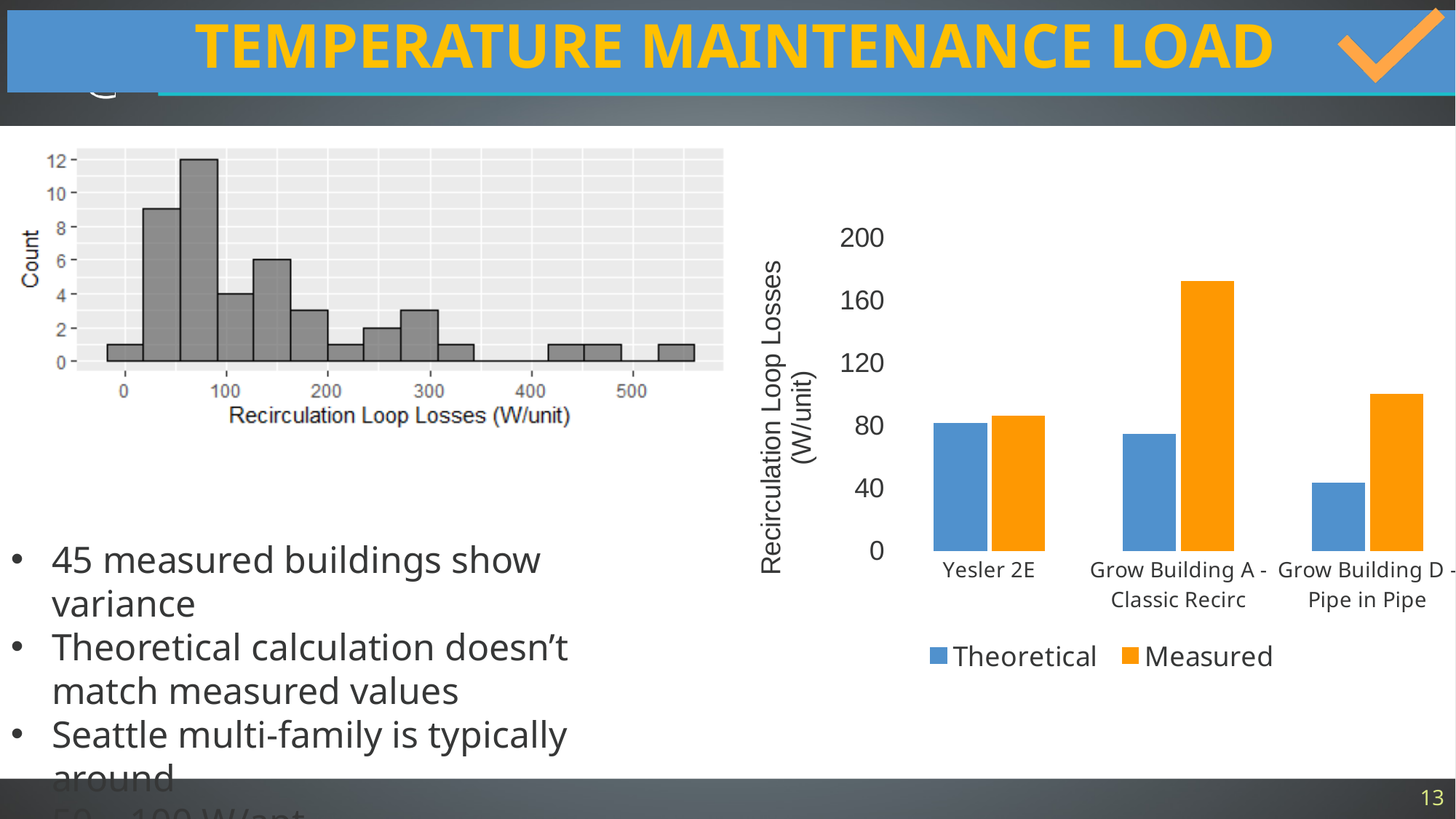
In the chart on the right, is the Measured value for Grow Building A - Classic Recirc greater or less than 160? greater What kind of chart is the chart on the right of the slide? bar chart In the histogram on the left, what is the highest count reached by any bar? 12 In the chart on the right, what are the two entries in the legend? Theoretical and Measured In the chart on the right, which building has the highest Measured value? Grow Building A - Classic Recirc In the chart on the right, how many series does the legend list? 2 In the chart on the right, is the Measured value for Grow Building D - Pipe in Pipe greater or less than 80? greater In the histogram on the left, what is the label of the x axis? Recirculation Loop Losses (W/unit) In the chart on the right, which building has the lowest Theoretical value? Grow Building D - Pipe in Pipe In the chart on the right, is the Theoretical value for Grow Building A - Classic Recirc greater or less than 80? less In the chart on the right, how many buildings are shown on the x axis? 3 In the chart on the right, which is larger for Grow Building A - Classic Recirc, the Theoretical or the Measured value? Measured